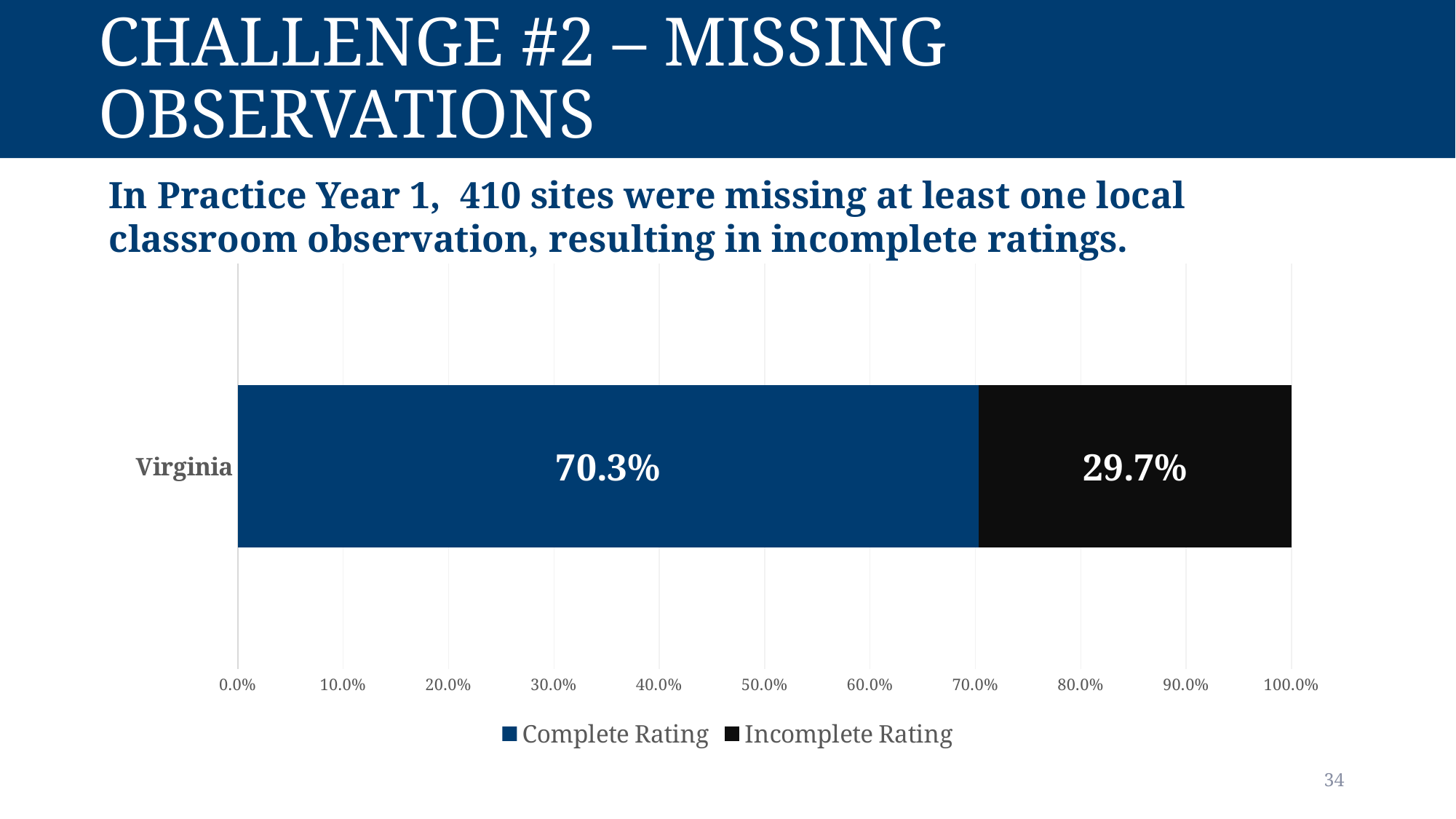
What is the total of the stacked bar for Virginia? 100.0% How many categories are shown on the chart? 1 What is the value for Incomplete Rating for Virginia? 29.7% Which series is shown in black in the chart? Incomplete Rating What is the label of the category shown on the chart? Virginia Is the Incomplete Rating value for Virginia greater or less than 30.0%? less Which series has the larger value for Virginia, Complete Rating or Incomplete Rating? Complete Rating Is the Complete Rating value for Virginia greater or less than 60.0%? greater What is the value for Complete Rating for Virginia? 70.3% What is the difference between the Complete Rating and Incomplete Rating values for Virginia? 40.6% What kind of chart is shown on the slide? Stacked bar chart How many series does the legend list? 2